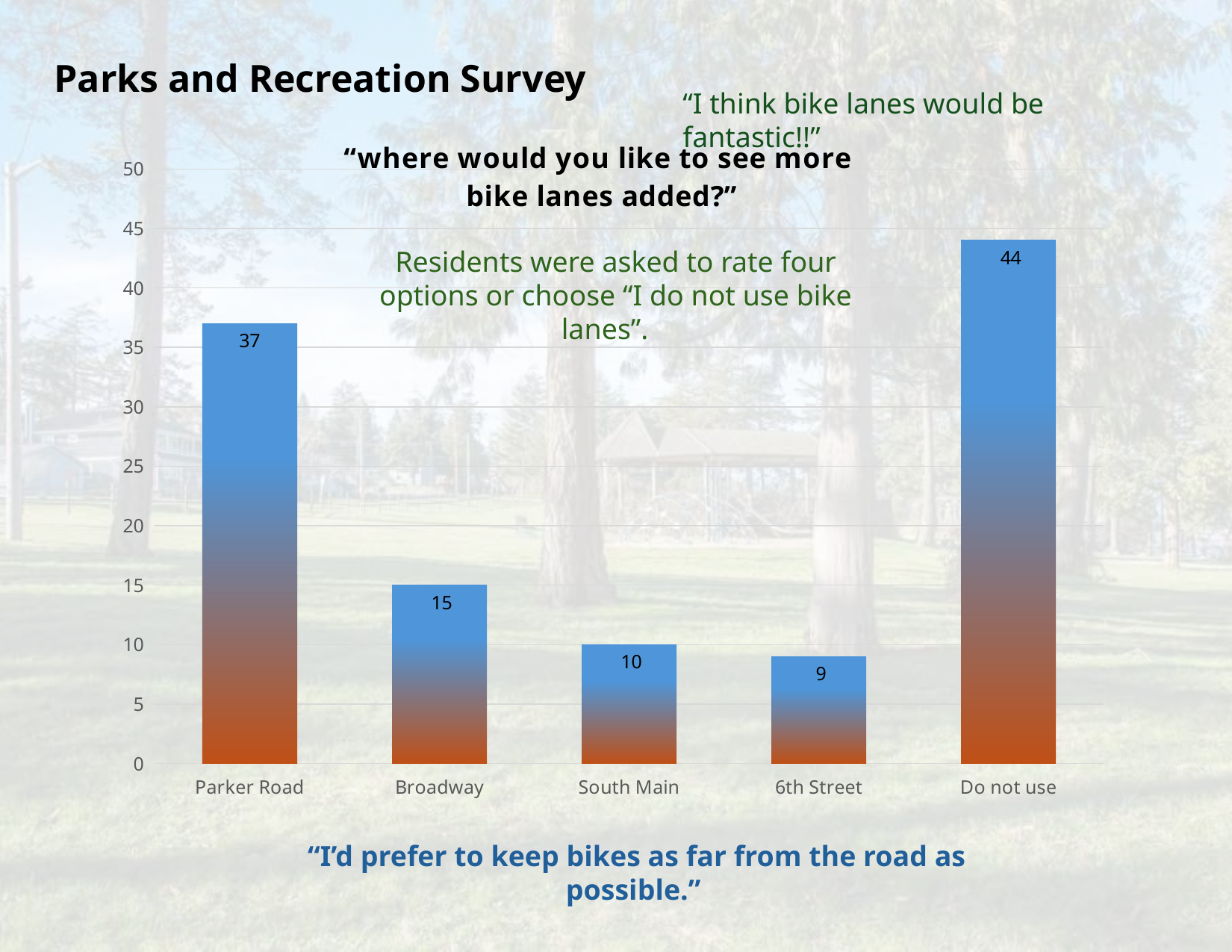
What is the value for Parker Road? 37 What kind of chart is shown on the slide? bar chart What is the title of the chart? "where would you like to see more bike lanes added?" What is the value for 6th Street? 9 Which is larger, the value for Parker Road or the value for Broadway? Parker Road How many categories are shown on the x axis? 5 What is the value for Broadway? 15 Is the value for South Main greater or less than 15? less Which category has the lowest value? 6th Street What is the difference between the values for Do not use and Parker Road? 7 Which category has the highest value? Do not use What is the difference between the values for Broadway and South Main? 5